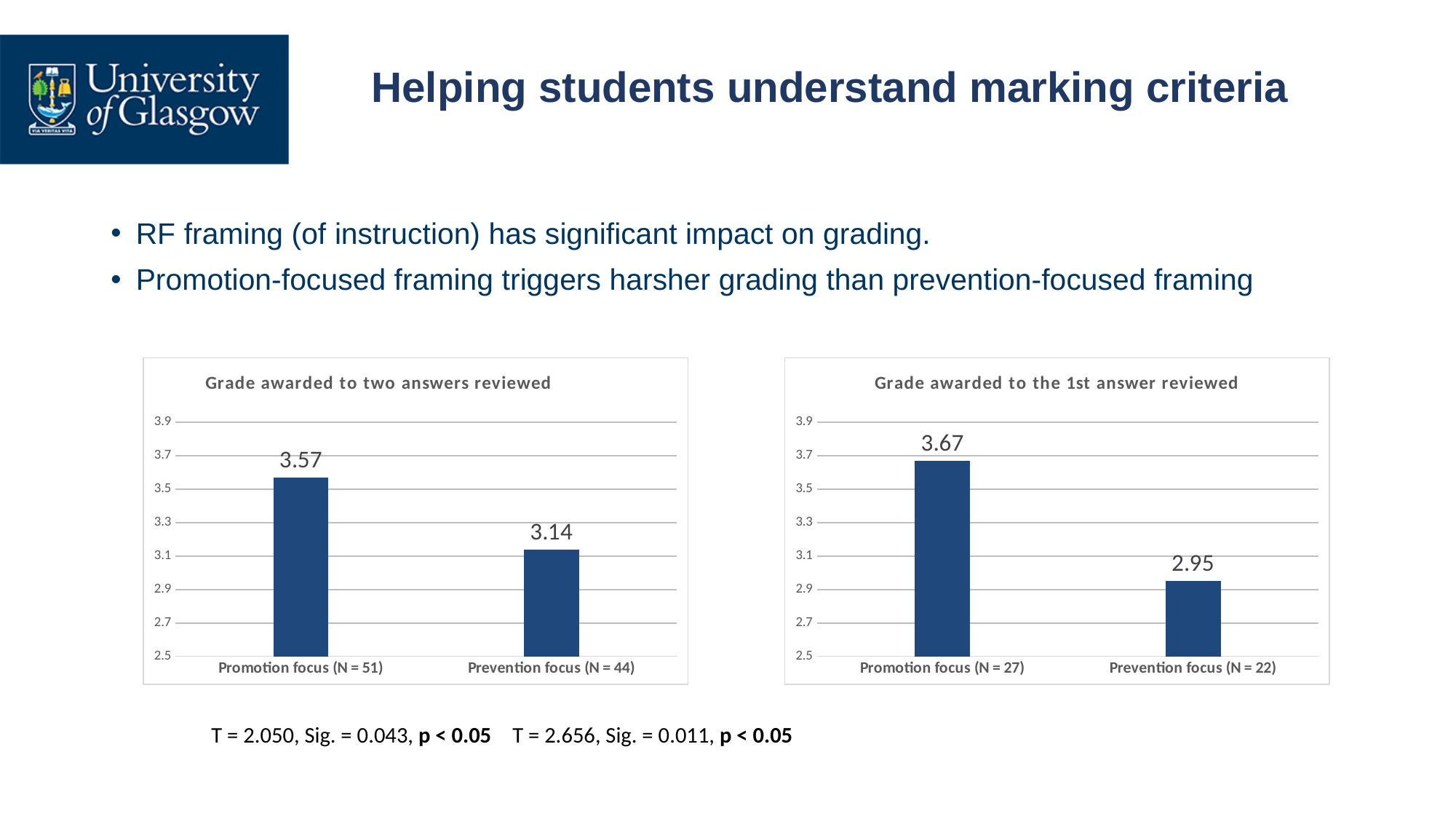
What is the title of the chart on the left of the slide? Grade awarded to two answers reviewed In the chart titled 'Grade awarded to two answers reviewed', what is the difference between the Promotion focus and Prevention focus values? 0.43 What kind of chart is the chart titled 'Grade awarded to the 1st answer reviewed'? bar chart In the chart titled 'Grade awarded to the 1st answer reviewed', what is the value for Promotion focus (N = 27)? 3.67 In the chart titled 'Grade awarded to the 1st answer reviewed', what is the difference between the Promotion focus and Prevention focus values? 0.72 In the chart titled 'Grade awarded to the 1st answer reviewed', which category has the lowest value? Prevention focus (N = 22) In the chart titled 'Grade awarded to two answers reviewed', which category has the highest value? Promotion focus (N = 51) In the chart titled 'Grade awarded to two answers reviewed', what is the value for Prevention focus (N = 44)? 3.14 In the chart titled 'Grade awarded to two answers reviewed', what is the value for Promotion focus (N = 51)? 3.57 In the chart titled 'Grade awarded to the 1st answer reviewed', what is the value for Prevention focus (N = 22)? 2.95 In the chart titled 'Grade awarded to two answers reviewed', how many categories are shown? 2 In the chart titled 'Grade awarded to the 1st answer reviewed', is the value for Prevention focus (N = 22) greater or less than 3.1? less